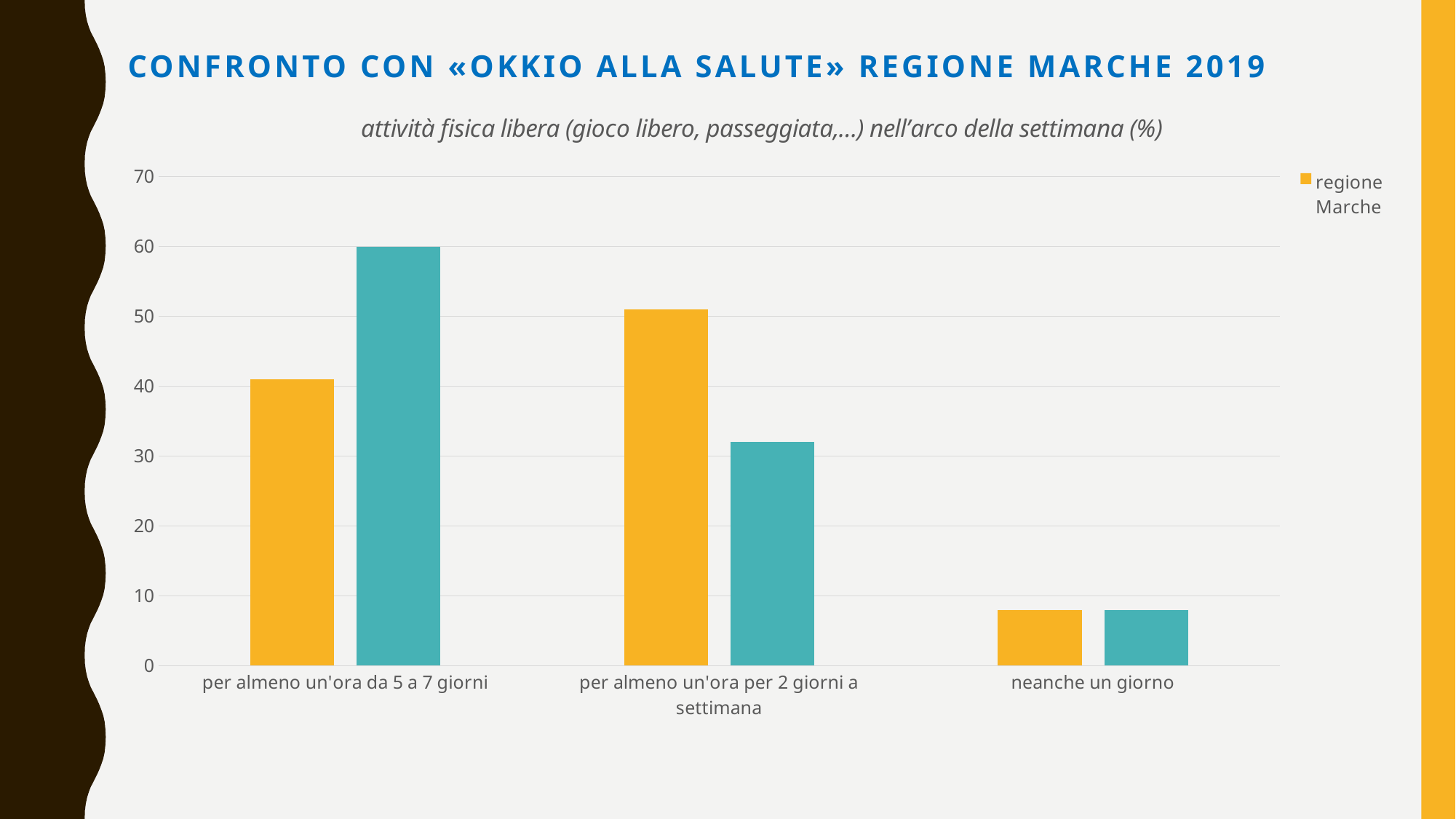
Is the regione Marche value for 'neanche un giorno' greater or less than 10? less Which series is named in the chart's legend? regione Marche What kind of chart is shown on the slide? bar chart Is the regione Marche value for 'per almeno un'ora per 2 giorni a settimana' greater or less than 60? less Is the regione Marche value for 'per almeno un'ora da 5 a 7 giorni' greater or less than 50? less How many series does the chart's legend list? 1 How many categories are shown on the x axis of the chart? 3 What is the chart's title? attività fisica libera (gioco libero, passeggiata,...) nell'arco della settimana (%) For 'per almeno un'ora da 5 a 7 giorni', which bar is taller, the regione Marche bar or the teal bar? the teal bar For which category is the regione Marche value lowest? neanche un giorno For which category is the regione Marche value highest? per almeno un'ora per 2 giorni a settimana What is the value of the teal bar for 'per almeno un'ora da 5 a 7 giorni'? 60